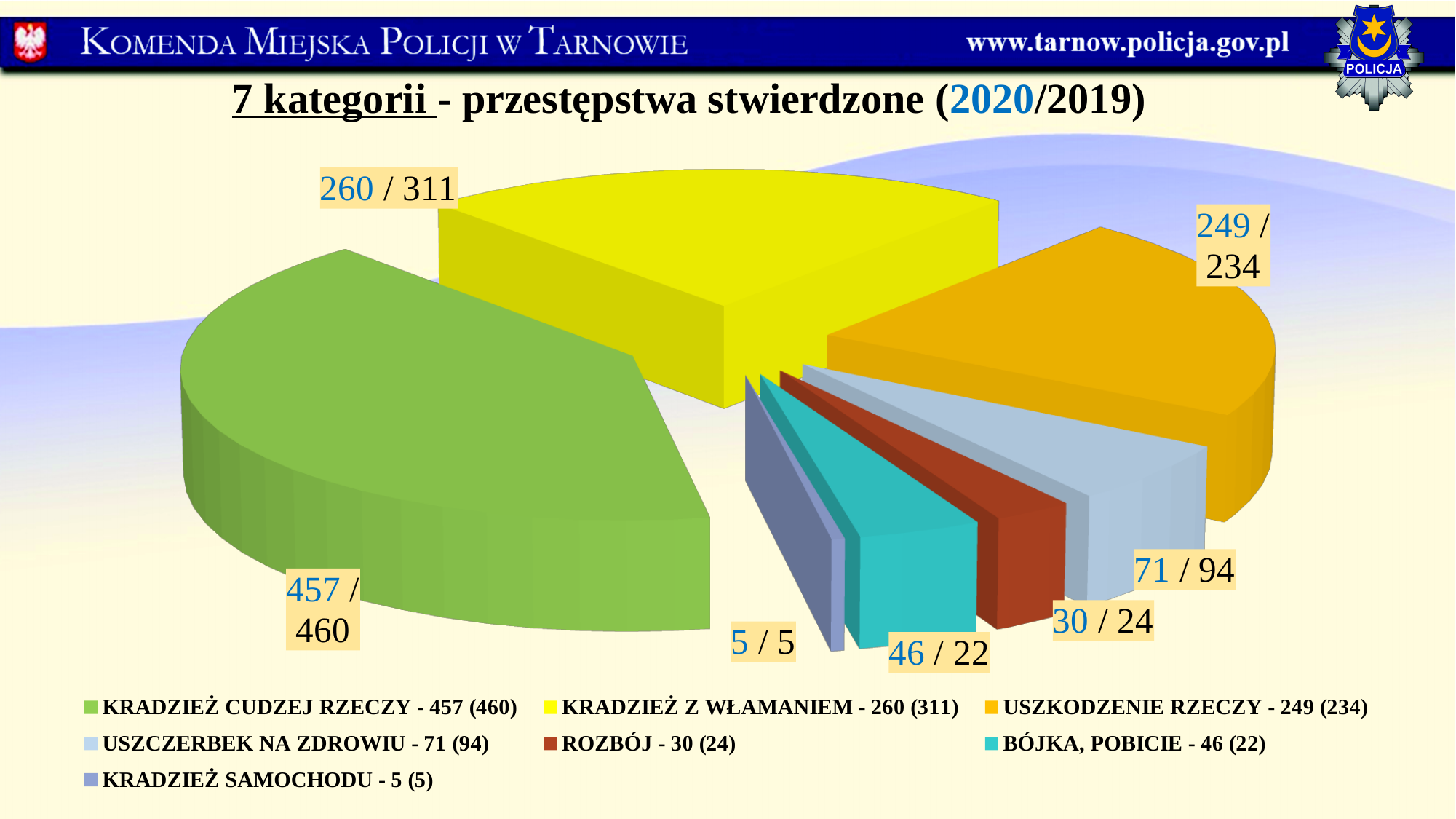
What colour is the slice for USZKODZENIE RZECZY? orange Which is larger in 2020: ROZBÓJ or BÓJKA, POBICIE? BÓJKA, POBICIE What is the 2019 value for KRADZIEŻ Z WŁAMANIEM? 311 What is the difference between the 2019 and 2020 values for KRADZIEŻ Z WŁAMANIEM? 51 What is the difference between the 2020 values for USZKODZENIE RZECZY and USZCZERBEK NA ZDROWIU? 178 How many categories does the pie chart show? 7 What kind of chart is shown on the slide? pie chart Which category has the smallest 2020 value? KRADZIEŻ SAMOCHODU What is the 2020 value for BÓJKA, POBICIE? 46 What is the 2020 value for KRADZIEŻ CUDZEJ RZECZY? 457 How many entries does the legend list? 7 Which category has the largest 2020 value? KRADZIEŻ CUDZEJ RZECZY